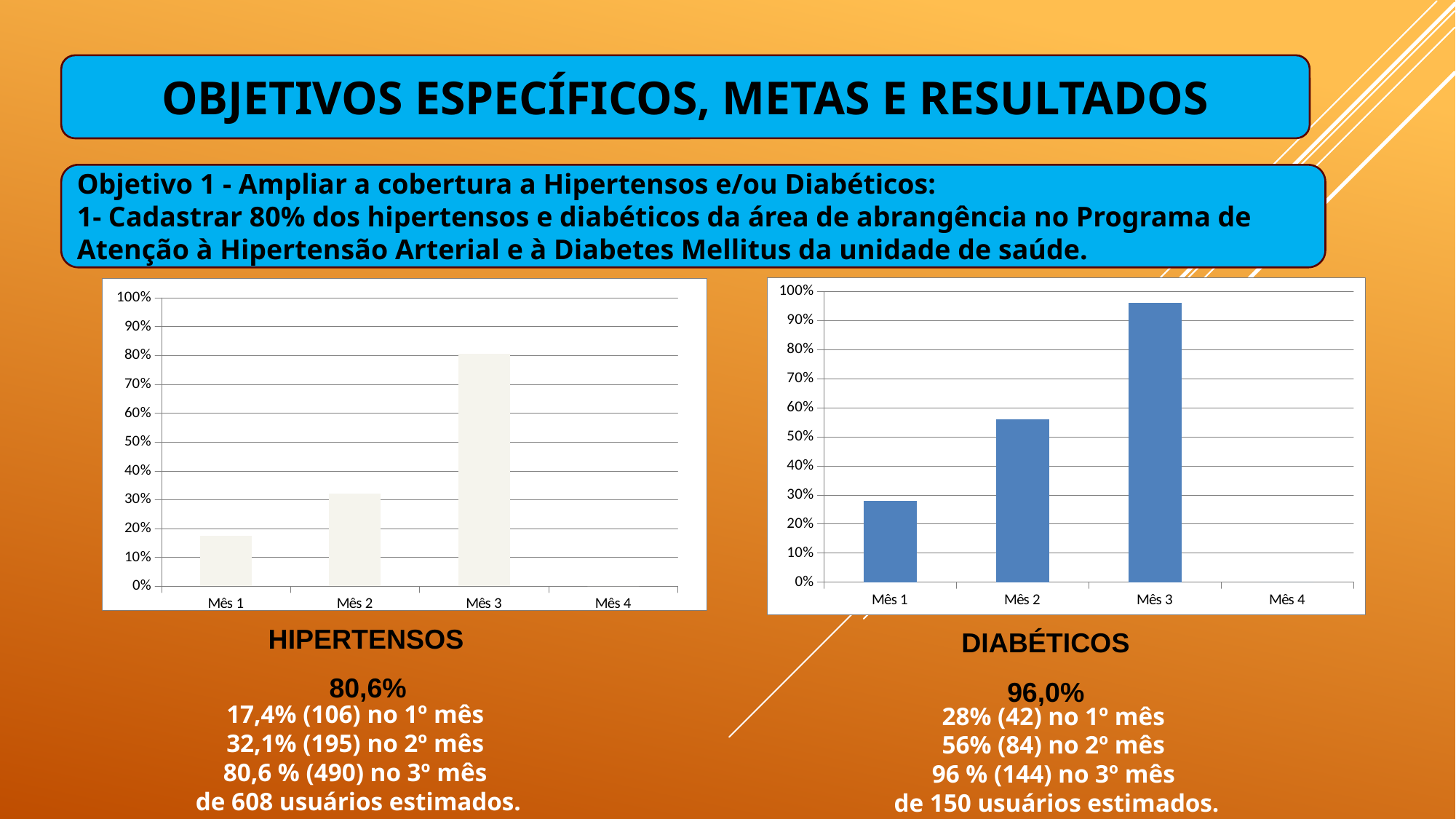
In the HIPERTENSOS chart, which month has the highest bar? Mês 3 Which is larger: the Mês 3 value in the HIPERTENSOS chart or the Mês 3 value in the DIABÉTICOS chart? DIABÉTICOS In the DIABÉTICOS chart, is the value for Mês 3 greater or less than 90%? greater In the HIPERTENSOS chart, is the value for Mês 1 greater or less than 20%? less According to the text under the HIPERTENSOS chart, what percentage was reached in the 3º mês? 80,6 % How many categories are shown on the x axis of the DIABÉTICOS chart on the right? 4 In the DIABÉTICOS chart, is the value for Mês 2 greater or less than 60%? less What kind of chart is the HIPERTENSOS chart on the left? bar chart According to the text under the DIABÉTICOS chart, what percentage was reached in the 1º mês? 28% In the DIABÉTICOS chart, which month with a bar has the lowest value? Mês 1 Do the bar values in the DIABÉTICOS chart rise or fall from Mês 1 to Mês 3? rise